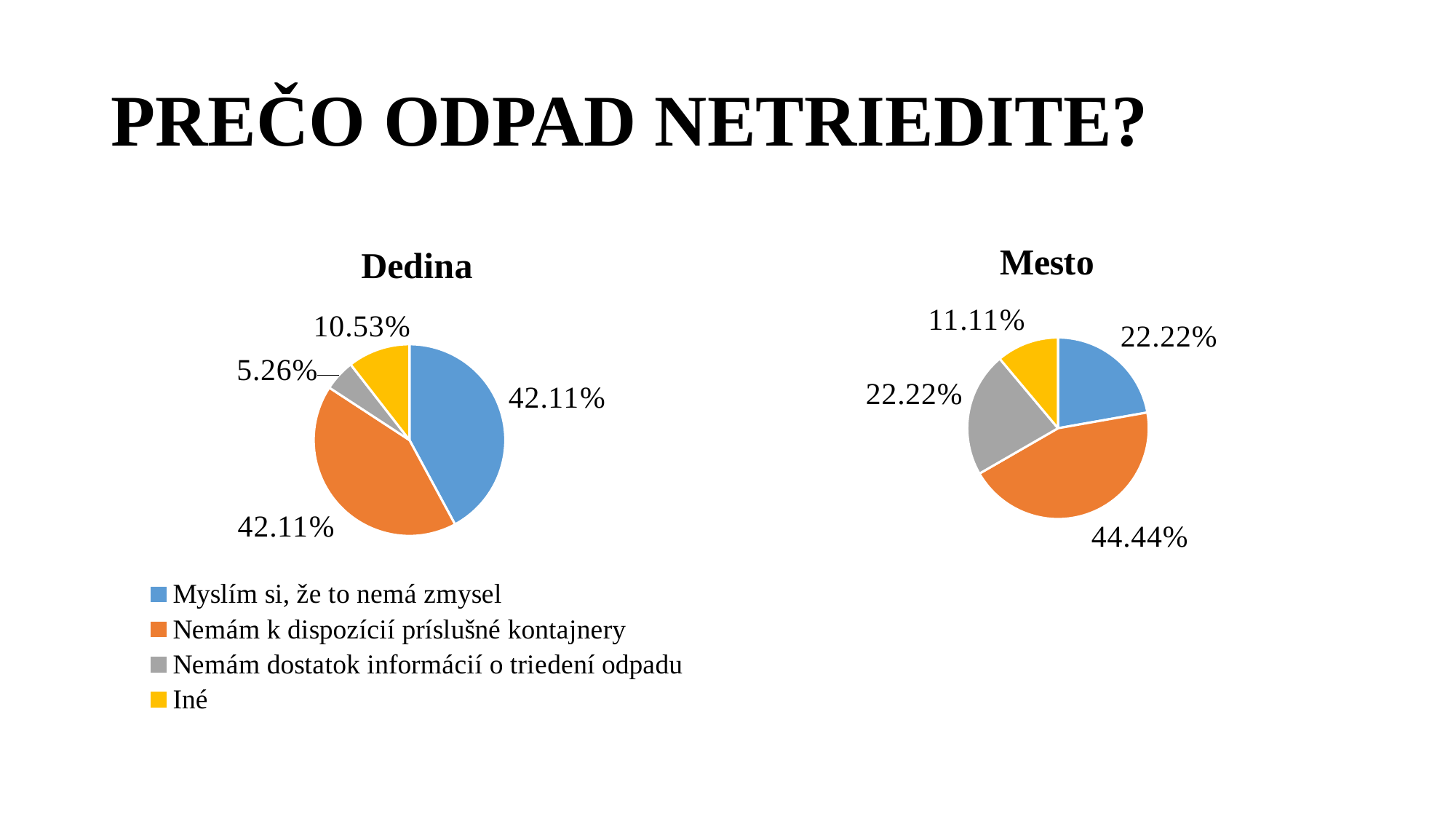
In the Dedina chart, which category has the smallest slice? Nemám dostatok informácií o triedení odpadu Which chart shows a larger share for "Nemám dostatok informácií o triedení odpadu", Dedina or Mesto? Mesto What type of chart is the Dedina chart? Pie chart In the Mesto chart, what share is shown for "Myslím si, že to nemá zmysel"? 22.22% In the Dedina chart, what share is shown for "Nemám dostatok informácií o triedení odpadu"? 5.26% In the Mesto chart, which category has the smallest slice? Iné In the Mesto chart, what share is shown for "Nemám k dispozícií príslušné kontajnery"? 44.44% In the Mesto chart, which category has the largest slice? Nemám k dispozícií príslušné kontajnery In the Mesto chart, what is the difference between the share for "Nemám k dispozícií príslušné kontajnery" and the share for "Iné"? 33.33% In the Mesto chart, what share is shown for "Iné"? 11.11% How many categories does the legend list for the charts? 4 In the Dedina chart, what share is shown for "Iné"? 10.53%